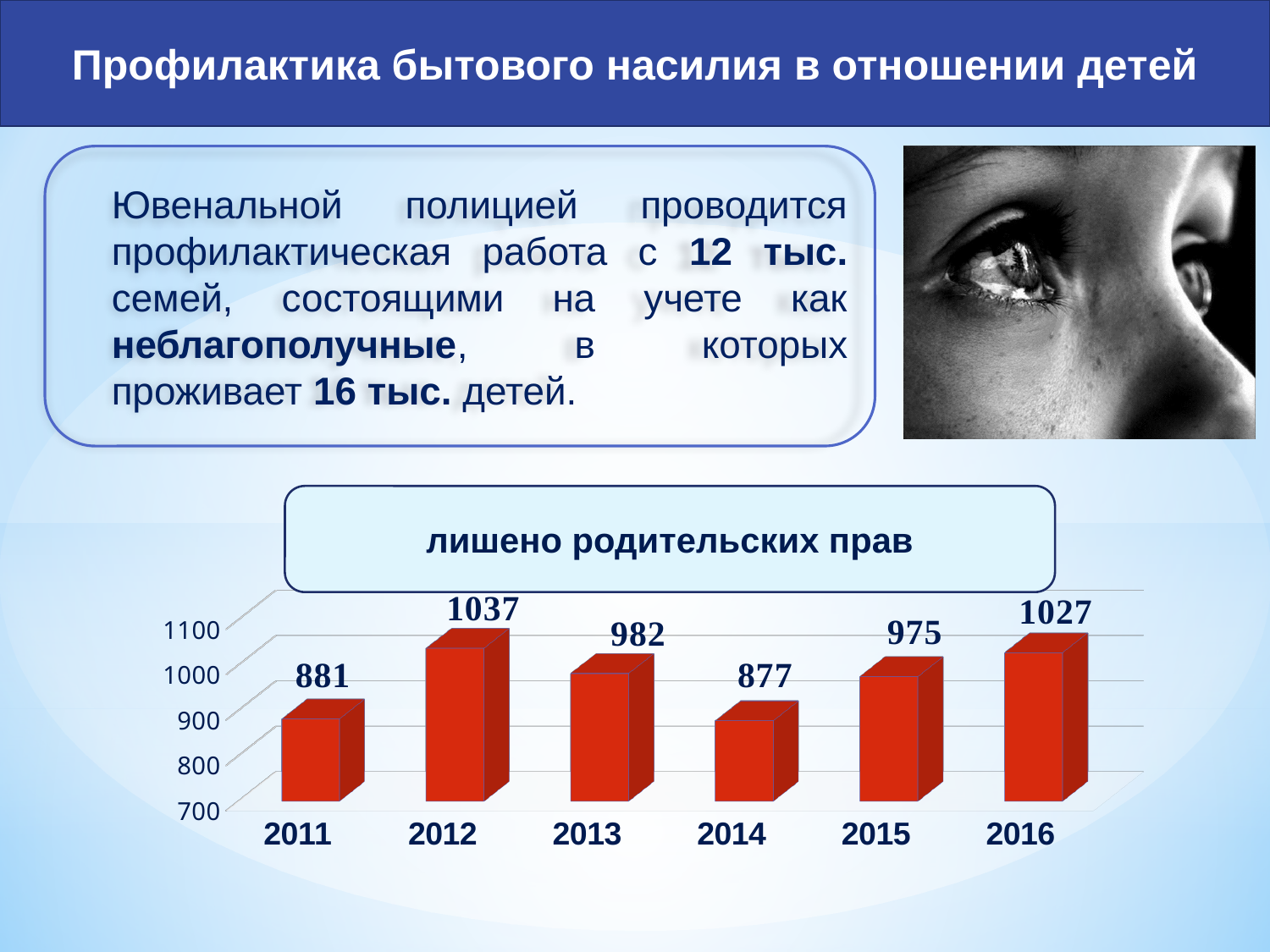
How many years are shown on the x axis of the chart? 6 Is the value for 2011 greater or less than 900? less What is the difference between the values for 2016 and 2015? 52 What is the value for 2016 in the chart? 1027 What is the title of the chart on the slide? лишено родительских прав Which year has the lowest value in the chart? 2014 What kind of chart is shown on the slide? bar chart What is the value for 2014 in the chart? 877 Which is larger, the value for 2013 or the value for 2015? 2013 What is the difference between the values for 2012 and 2011? 156 Which year has the highest value in the chart? 2012 What is the value for 2012 in the chart 'лишено родительских прав'? 1037